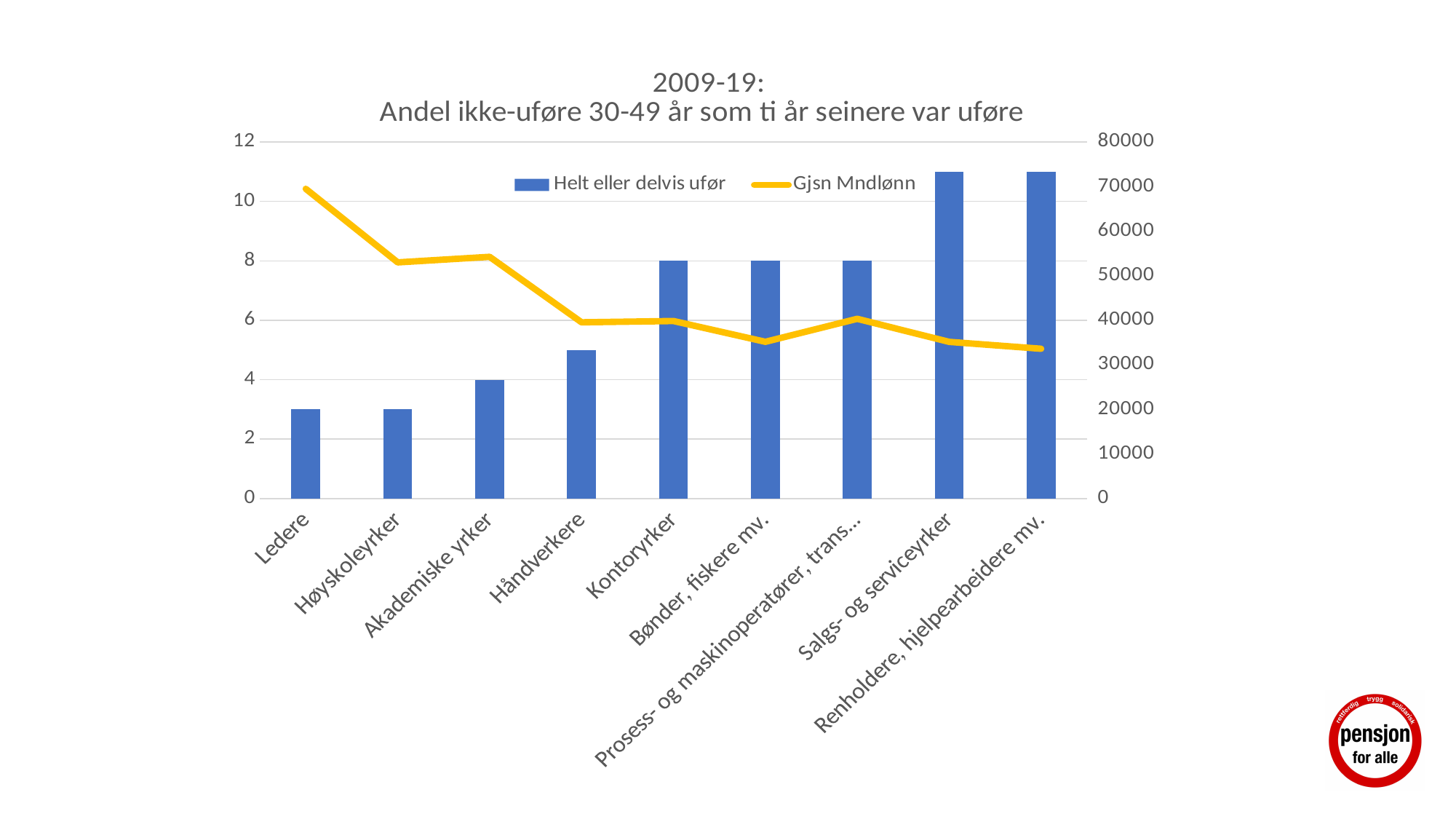
Do the 'Gjsn Mndlønn' values generally rise or fall from left to right along the x axis? fall Is the 'Helt eller delvis ufør' value for Salgs- og serviceyrker greater or less than 10? greater Is the 'Helt eller delvis ufør' value for Ledere greater or less than 4? less What is the value of the 'Helt eller delvis ufør' bar for Akademiske yrker? 4 Which has the larger 'Helt eller delvis ufør' value, Håndverkere or Kontoryrker? Kontoryrker How many series does the legend list? 2 Is the 'Gjsn Mndlønn' value for Ledere greater or less than 60000? greater Which category has the highest 'Gjsn Mndlønn' value? Ledere Which has the larger 'Gjsn Mndlønn' value, Høyskoleyrker or Håndverkere? Høyskoleyrker What is the value of the 'Helt eller delvis ufør' bar for Kontoryrker? 8 How many categories are shown on the x axis? 9